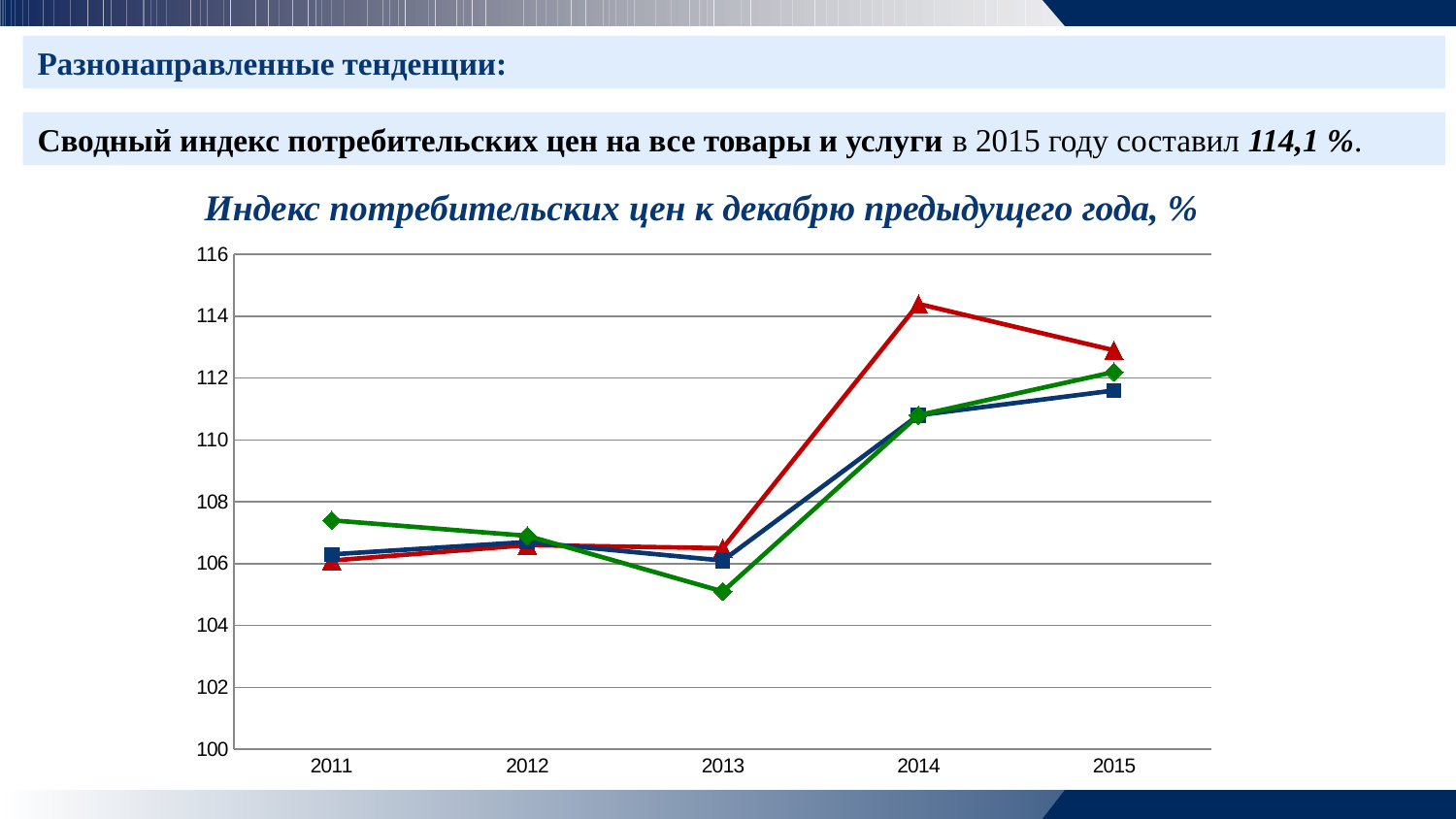
In which year does the red line (triangle markers) reach its highest value? 2014 Is the value of the blue line (square markers) in 2015 greater or less than 110? greater What is the highest value marked on the y axis of the chart? 116 Is the value of the green line (diamond markers) in 2013 greater or less than 106? less What kind of chart is shown on the slide? line chart Which line has the highest value in 2014? the red line Does the red line rise or fall from 2014 to 2015? fall What is the title of the chart? Индекс потребительских цен к декабрю предыдущего года, % In 2015, which line has the larger value: the red line or the blue line? the red line In which year does the green line (diamond markers) reach its lowest value? 2013 Is the value of the red line (triangle markers) in 2014 greater or less than 112? greater How many years are shown along the x axis of the chart? 5